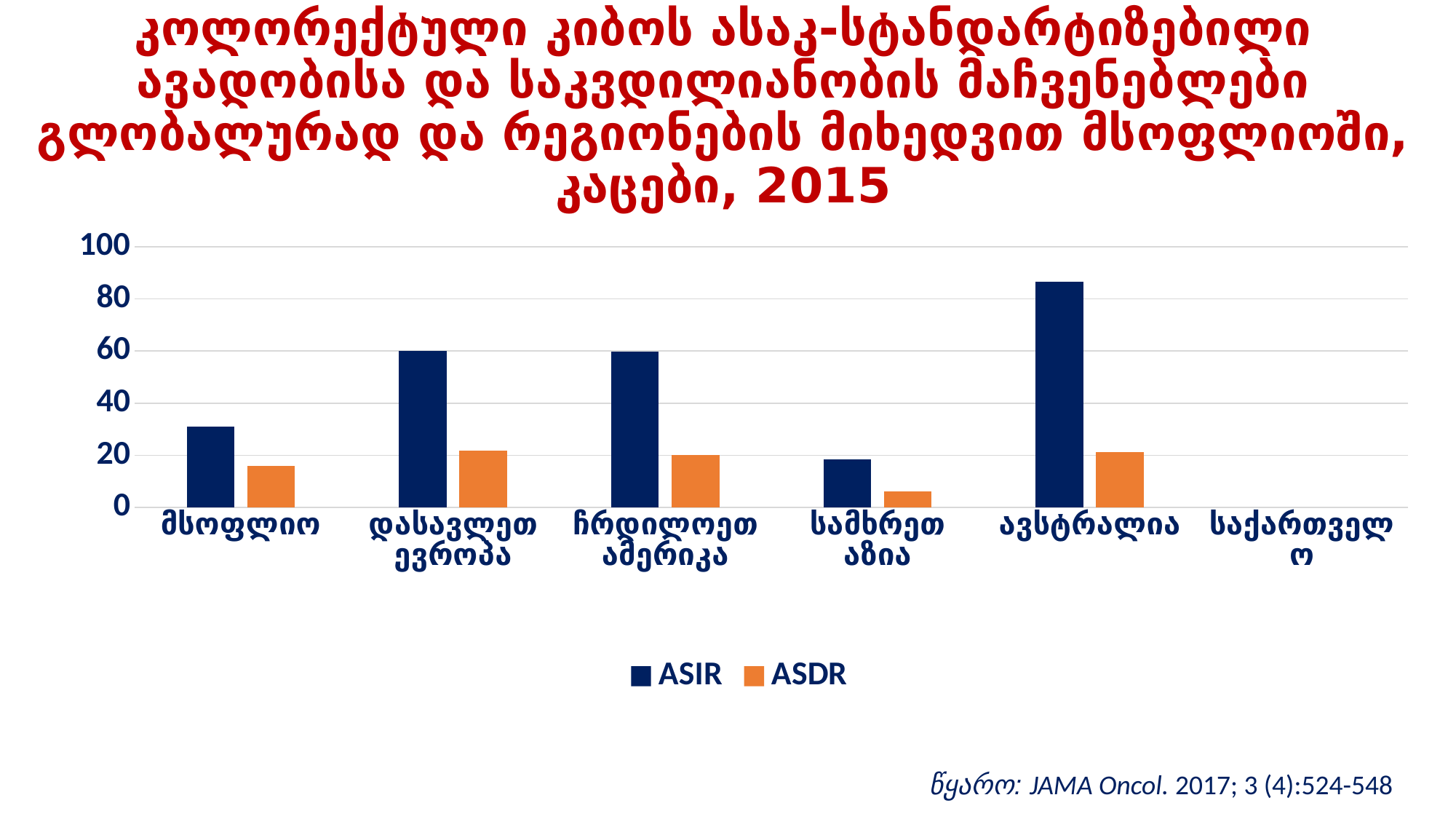
Which series is shown in dark blue in the legend? ASIR Is the ASIR value for ავსტრალია greater or less than 80? greater Which category has the lowest ASDR value among those with a visible bar? სამხრეთ აზია Is the ASIR value for დასავლეთ ევროპა greater or less than 40? greater Which series is shown in orange in the legend? ASDR Which is larger, the ASIR value for მსოფლიო or the ASIR value for სამხრეთ აზია? მსოფლიო How many series does the legend list? 2 Is the ASDR value for სამხრეთ აზია greater or less than 20? less How many categories are shown on the x axis? 6 What kind of chart is shown on the slide? bar chart Which category has the highest ASIR value? ავსტრალია